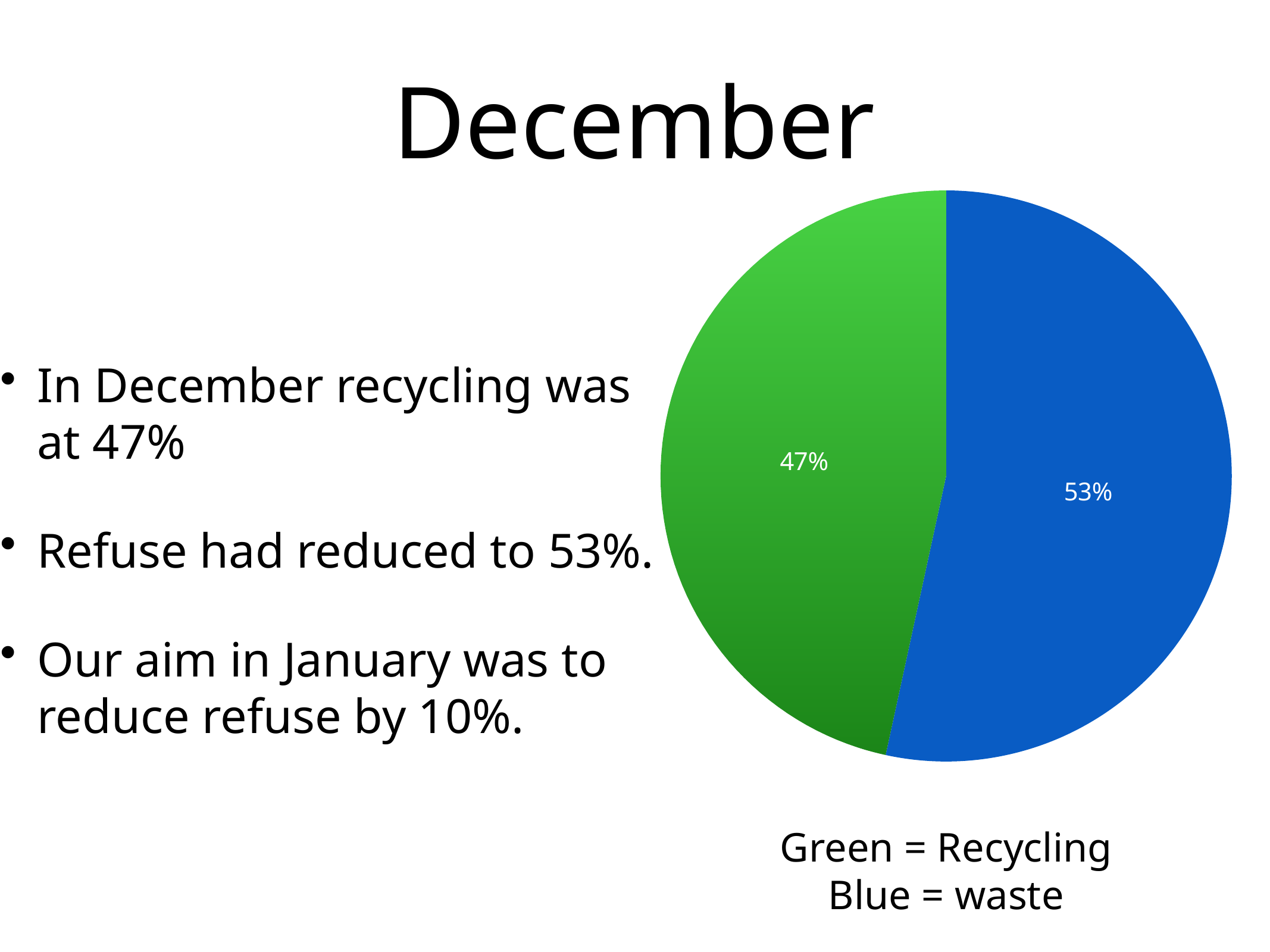
How many slices does the pie chart have? 2 Is the value for Recycling greater or less than 50%? less What kind of chart is shown on the slide? pie chart Which category has the smallest slice of the pie? Recycling Which category has the largest slice of the pie? waste What colour represents Recycling in the pie chart? Green Which slice is larger, Recycling or waste? waste What colour represents waste in the pie chart? Blue What share of the pie does the green (Recycling) slice represent? 47% What share of the pie does the blue (waste) slice represent? 53% What is the difference in percentage points between the waste slice and the Recycling slice? 6% Is the value for waste greater or less than 50%? greater